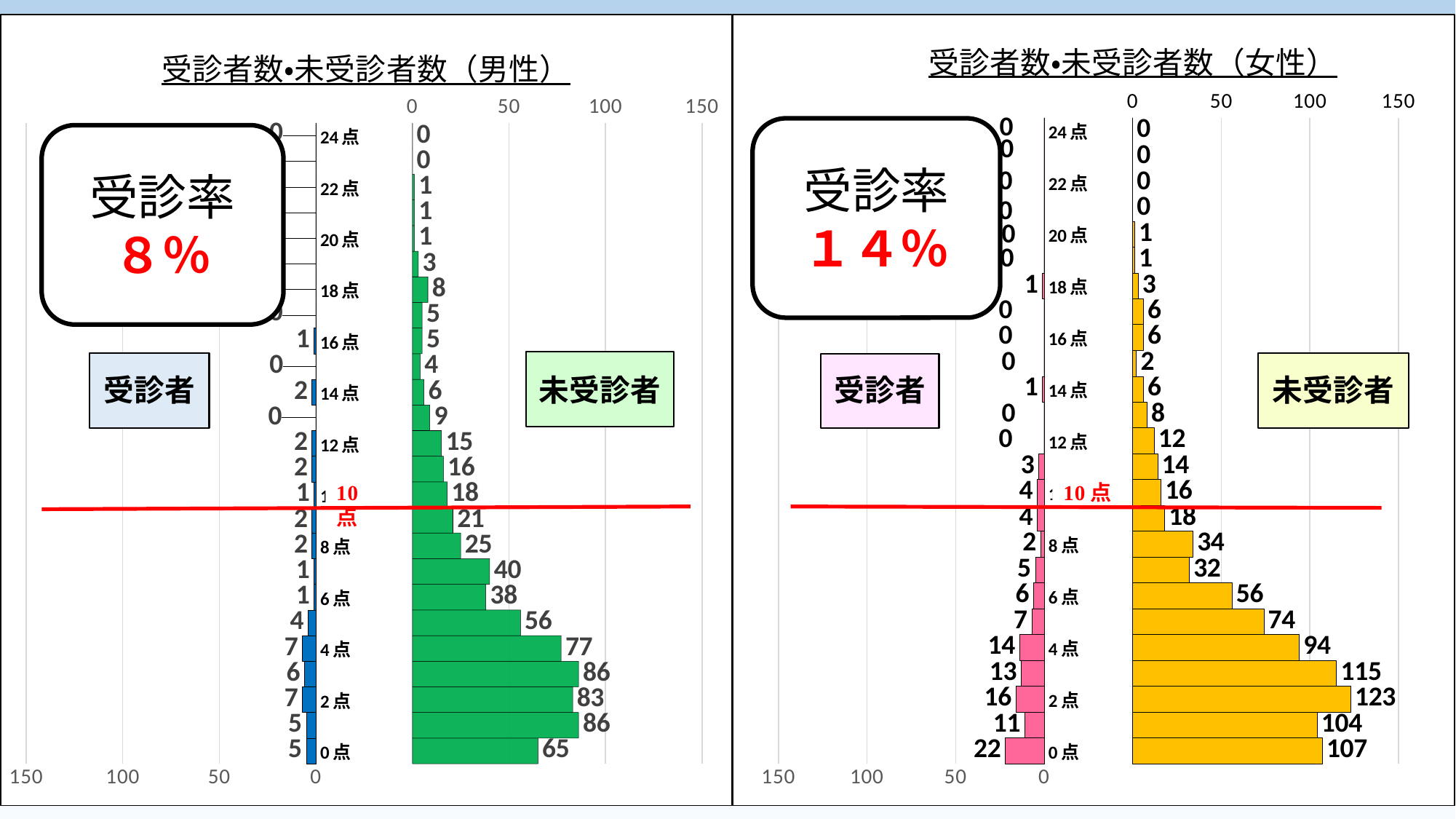
On the right chart (女性), is the 未受診者 value for 4点 greater or less than 50? greater What 受診率 is shown in the box on the right chart (女性)? 14% On the right chart (女性), what is the difference between the 未受診者 values for 2点 and 0点? 16 On the left chart (男性), which is larger, the 未受診者 value for 0点 or for 4点? 4点 On the right chart (女性), which score category has the highest 受診者 value? 0点 On the right chart (女性), which score category has the highest 未受診者 value? 2点 On the right chart (女性), what is the 未受診者 value for 2点? 123 On the left chart (男性), what is the 未受診者 value for 0点? 65 On the left chart (男性), what is the difference between the 未受診者 values for 4点 and 6点? 39 On the right chart (女性), what is the 受診者 value for 0点? 22 On the left chart (男性), what is the 受診者 value for 4点? 7 What kind of chart is shown on the left side of the slide? bar chart